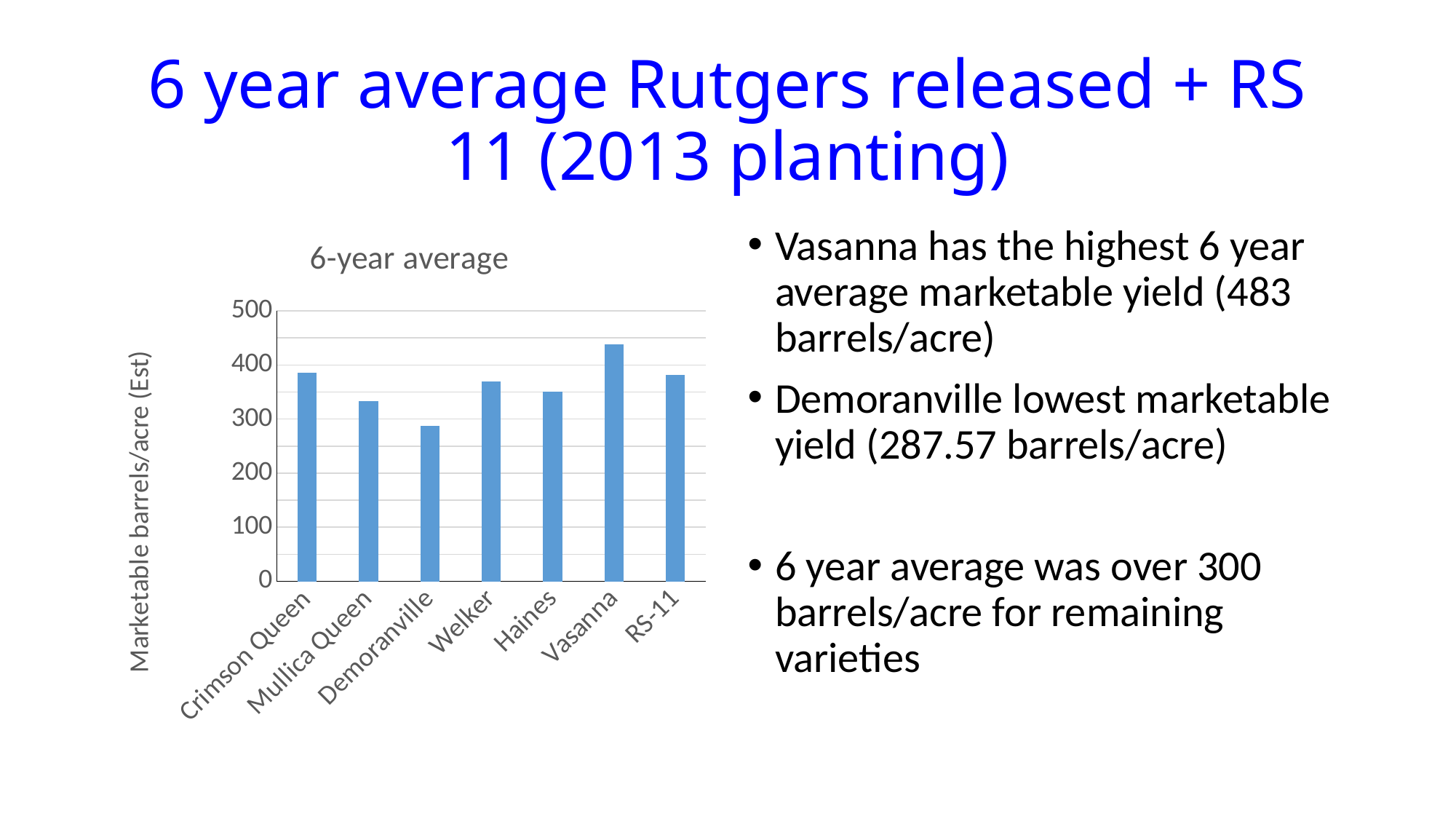
Which variety has the lowest 6-year average marketable yield in the chart? Demoranville What kind of chart is shown on the slide? bar chart Is the value for Haines greater or less than 400? less Which variety has the highest 6-year average marketable yield in the chart? Vasanna What is the title of the chart? 6-year average Is the value for Vasanna greater or less than 400? greater What is the label on the vertical axis of the chart? Marketable barrels/acre (Est) Is the value for Mullica Queen greater or less than 300? greater Which has a higher 6-year average, Crimson Queen or Mullica Queen? Crimson Queen How many varieties are plotted in the chart? 7 Which has a higher 6-year average, Vasanna or Haines? Vasanna